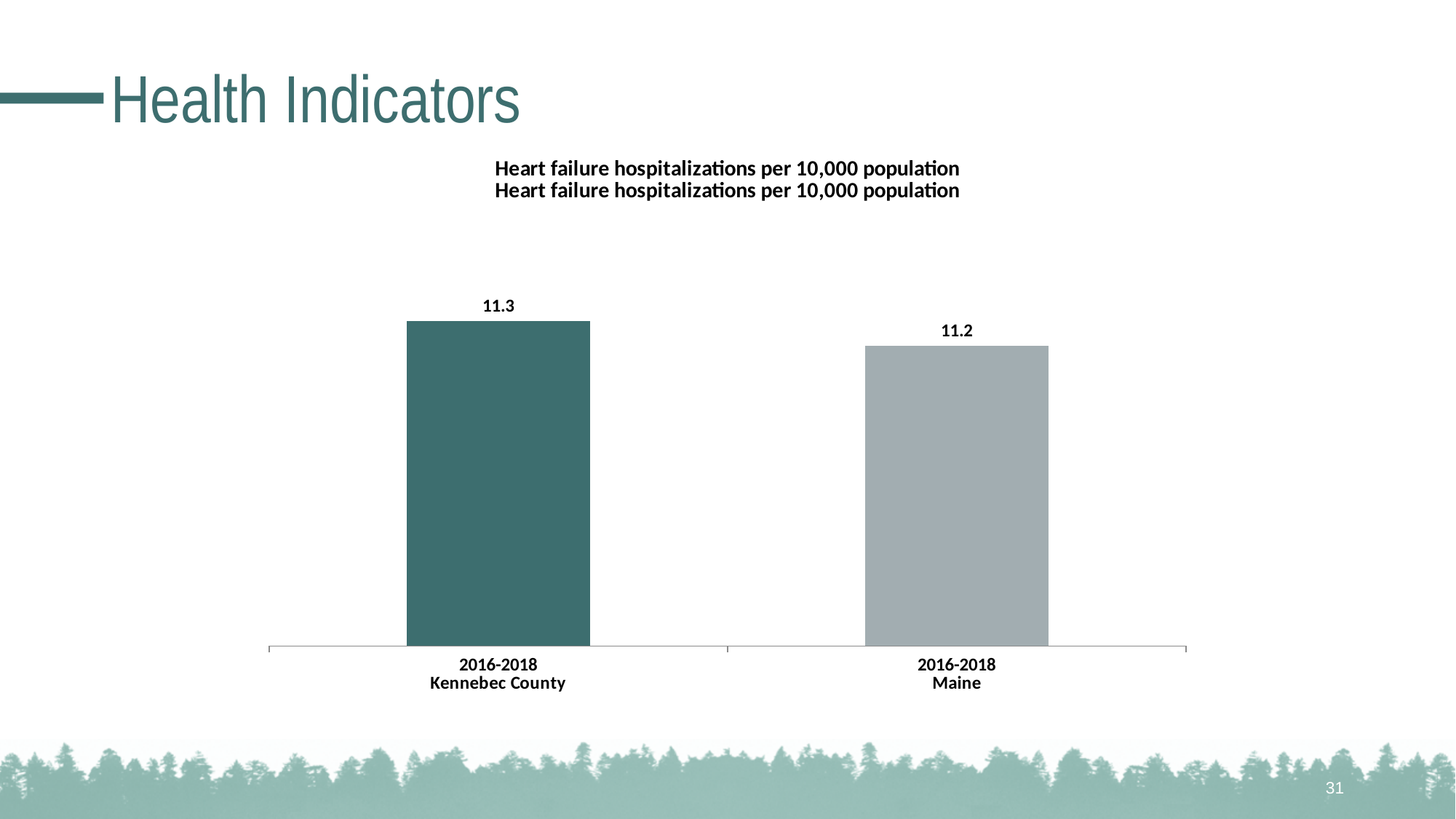
Which has the higher heart failure hospitalization rate, Kennebec County or Maine? Kennebec County What is the heart failure hospitalization rate per 10,000 population for Maine in 2016-2018? 11.2 How many bars are shown on the chart? 2 Which category has the lowest value on the chart? Maine What is the title of the chart? Heart failure hospitalizations per 10,000 population What is the difference between the Kennebec County and Maine heart failure hospitalization rates? 0.1 What is the heart failure hospitalization rate per 10,000 population for Kennebec County in 2016-2018? 11.3 What time period do the bars on the chart cover? 2016-2018 What type of chart is shown on the slide? Bar chart